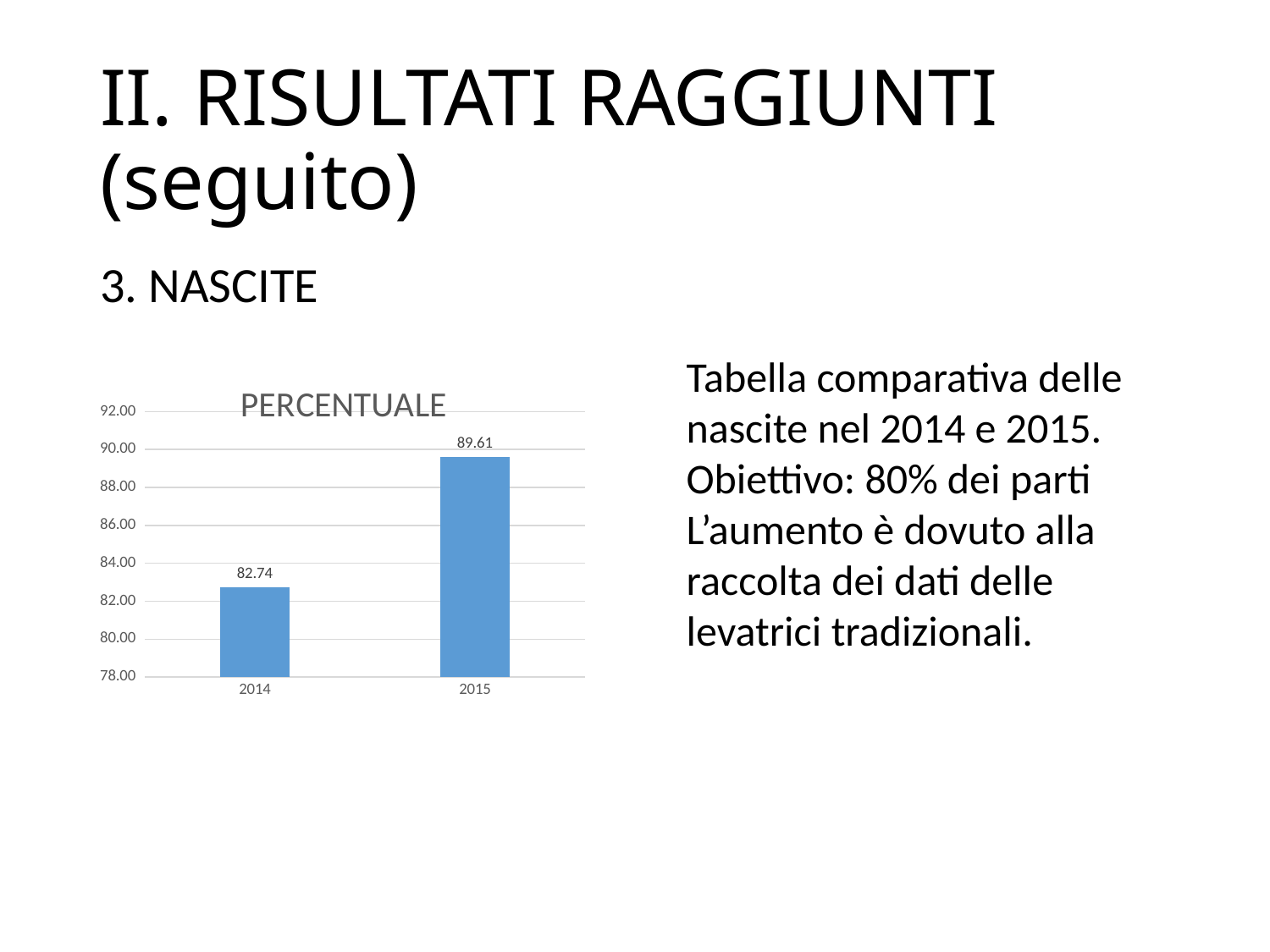
What kind of chart is shown on the slide? bar chart What is the value for 2015 in the PERCENTUALE chart? 89.61 Which is larger, the value for 2014 or the value for 2015? 2015 Which year has the highest value in the chart? 2015 What is the difference between the 2015 and 2014 values? 6.87 Which year has the lowest value in the chart? 2014 What is the title of the chart? PERCENTUALE What is the value for 2014 in the PERCENTUALE chart? 82.74 Do the values rise or fall from 2014 to 2015? rise How many categories are shown on the x axis of the chart? 2 Is the value for 2014 greater or less than 84.00? less Is the value for 2015 greater or less than 88.00? greater